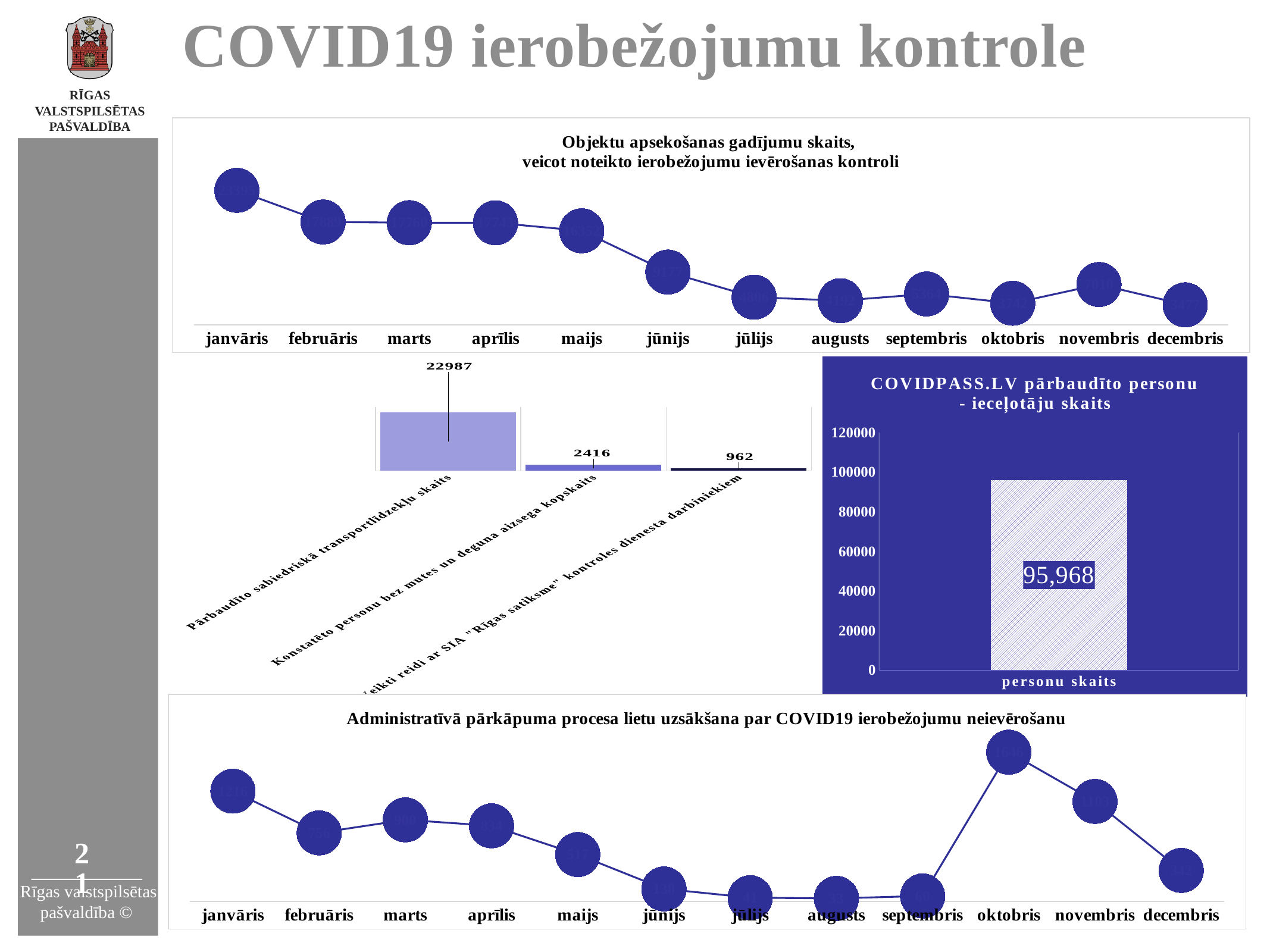
How many bars does the middle bar chart show? 3 How many months are plotted in the bottom chart titled "Administratīvā pārkāpuma procesa lietu uzsākšana par COVID19 ierobežojumu neievērošanu"? 12 In the middle bar chart, what is the value of the smallest bar? 962 In the middle bar chart, what is the difference between the value for "Pārbaidīto sabiedriskā transportlīdzekļu skaits" and the value for "Konstatēto personu bez mutes un deguna aizsega kopskaits"? 20571 In the middle bar chart, what is the value for "Konstatēto personu bez mutes un deguna aizsega kopskaits"? 2416 In the bottom chart titled "Administratīvā pārkāpuma procesa lietu uzsākšana par COVID19 ierobežojumu neievērošanu", which month has the highest value? oktobris In the chart titled "COVIDPASS.LV pārbaudīto personu - ieceļotāju skaits", what is the value for "personu skaits"? 95,968 In the middle bar chart, what is the value for "Pārbaudīto sabiedriskā transportlīdzekļu skaits"? 22987 In the top chart titled "Objektu apsekošanas gadījumu skaits, veicot noteikto ierobežojumu ievērošanas kontroli", which month has the highest value? janvāris What kind of chart is the chart titled "COVIDPASS.LV pārbaudīto personu - ieceļotāju skaits"? bar chart In the top chart titled "Objektu apsekošanas gadījumu skaits, veicot noteikto ierobežojumu ievērošanas kontroli", do the values rise or fall from janvāris to augusts? fall In the chart titled "COVIDPASS.LV pārbaudīto personu - ieceļotāju skaits", is the value for "personu skaits" greater or less than 100000? less